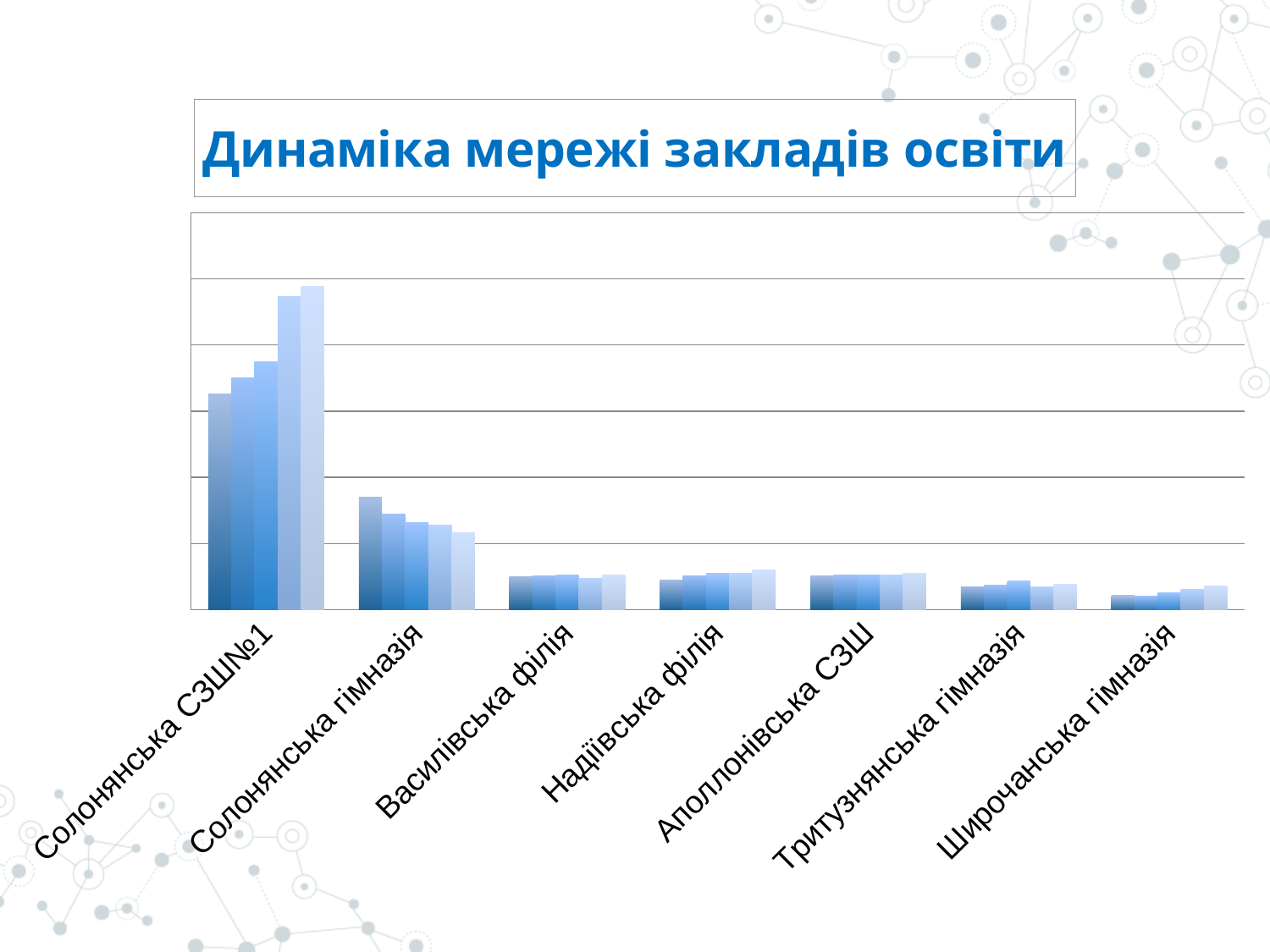
Which category has larger bars, Солонянська СЗШ№1 or Солонянська гімназія? Солонянська СЗШ№1 How many bars are plotted for each category in the chart? 5 Which category has the lowest bars in the chart? Широчанська гімназія Do the bars for Солонянська гімназія rise or fall from left to right? fall What colour are the bars in the chart? shades of blue Do the bars for Солонянська СЗШ№1 rise or fall from left to right? rise Which category is the second highest in the chart? Солонянська гімназія Which category has larger bars, Солонянська гімназія or Василівська філія? Солонянська гімназія Which category has the highest bars in the chart? Солонянська СЗШ№1 How many categories are shown on the x axis of the chart? 7 What is the title of the chart? Динаміка мережі закладів освіти What kind of chart is shown on the slide? bar chart